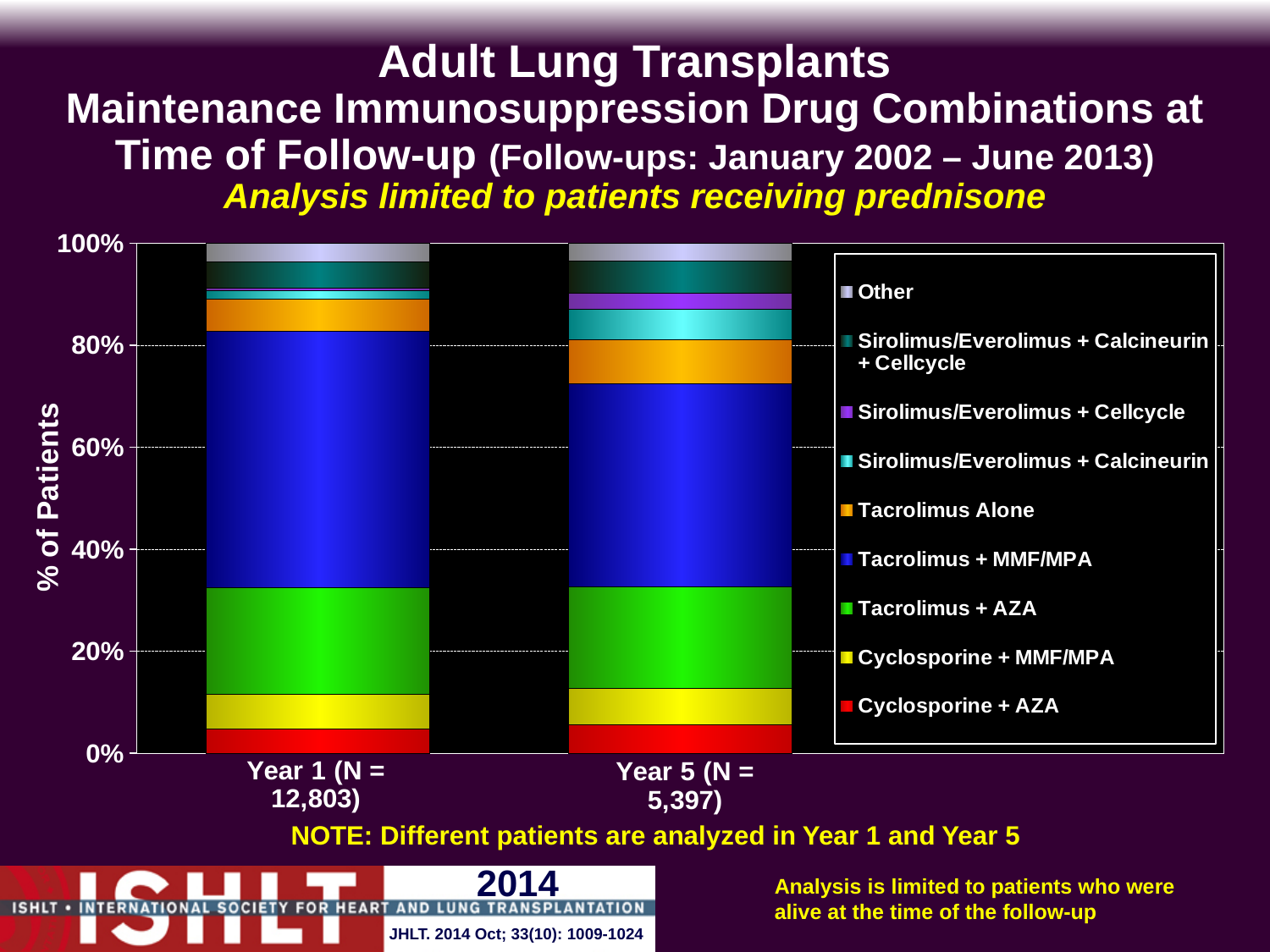
How many series does the legend list? 9 Which drug combination makes up the largest segment of the Year 5 bar? Tacrolimus + MMF/MPA What is the total height of each stacked bar? 100% Is the share of Tacrolimus + MMF/MPA in Year 1 greater or less than 40%? greater Is the share of Sirolimus/Everolimus + Calcineurin larger in Year 1 or in Year 5? Year 5 Is the share of Tacrolimus + MMF/MPA larger in Year 1 or in Year 5? Year 1 How many categories (bars) are plotted on the x axis? 2 What kind of chart is shown on the slide? Stacked bar chart What is the number of patients (N) for the Year 1 bar? 12,803 Is the share of Tacrolimus + AZA in Year 1 greater or less than 40%? less What is the label of the y axis? % of Patients Which drug combination makes up the largest segment of the Year 1 bar? Tacrolimus + MMF/MPA